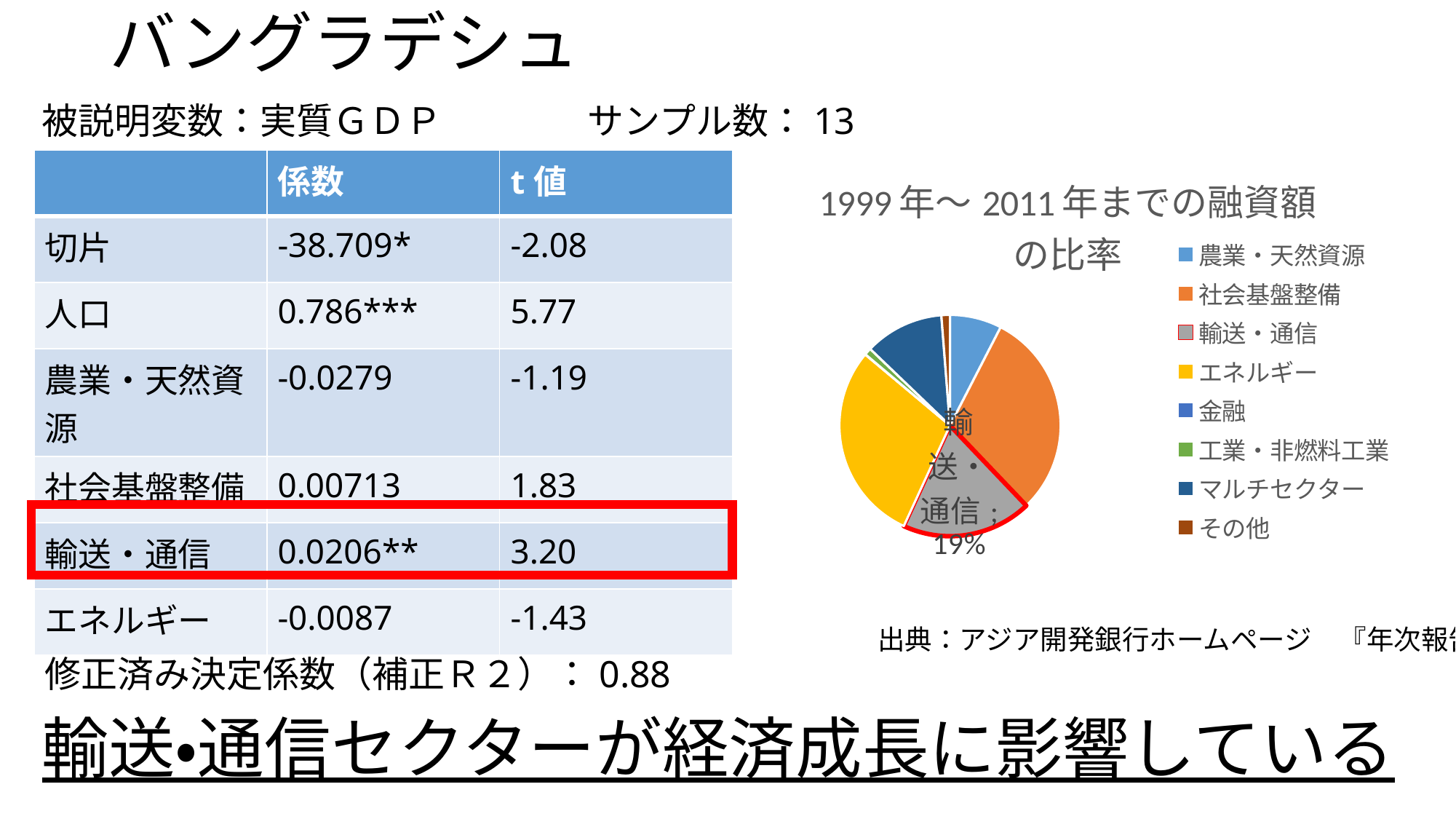
Which slice is larger, 社会基盤整備 or 輸送・通信? 社会基盤整備 Which slice is larger, 輸送・通信 or その他? 輸送・通信 Which slice is larger, エネルギー or マルチセクター? エネルギー What is the title of the pie chart? 1999年～2011年までの融資額の比率 What kind of chart is shown on the slide? pie chart What share of the pie does 輸送・通信 account for? 19% How many categories does the pie chart's legend list? 8 Which category has the largest slice in the pie chart? 社会基盤整備 Which slice of the pie chart is outlined in red? 輸送・通信